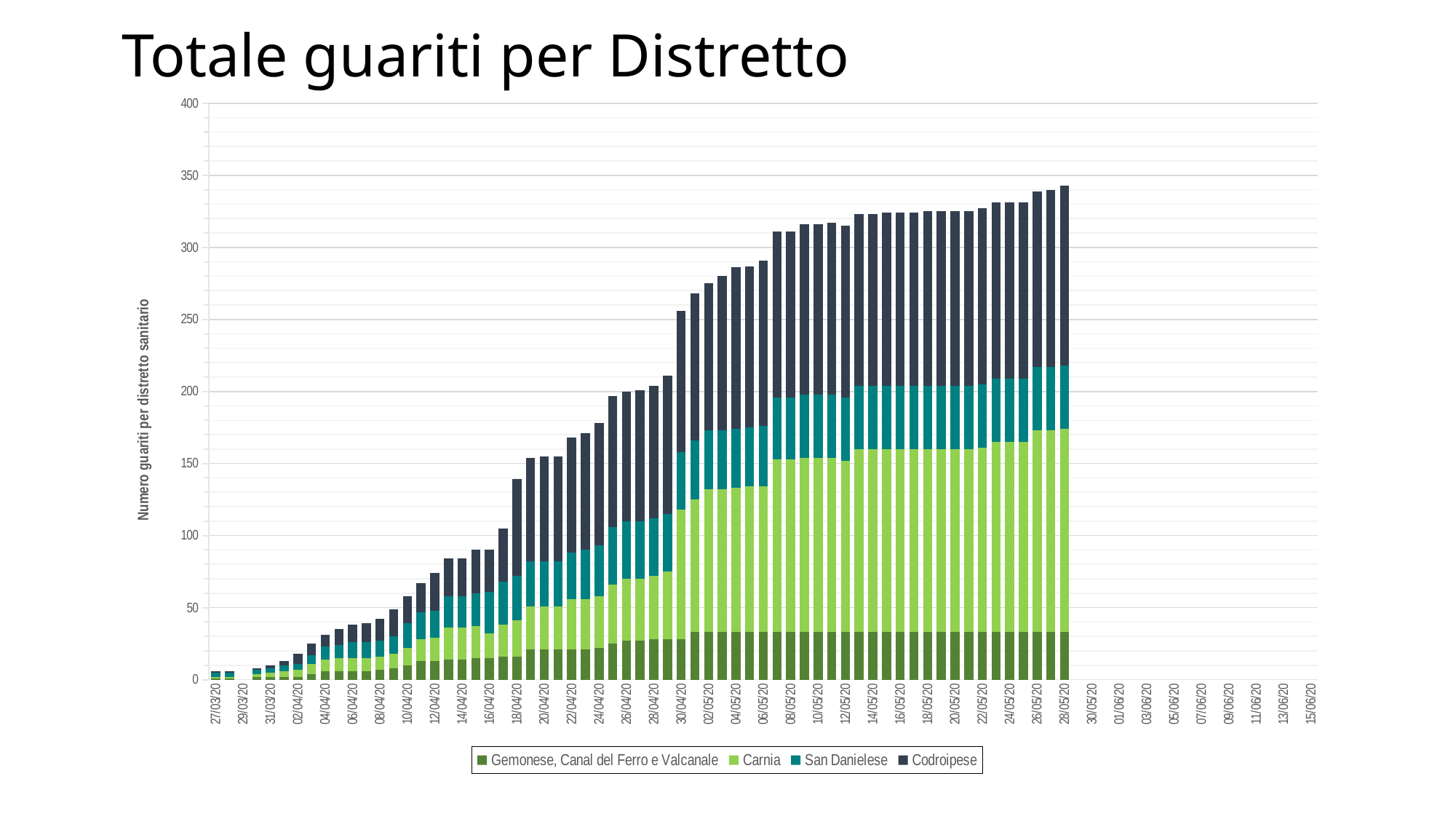
Is the total value for 20/04/20 greater or less than 100? greater Which has the larger total bar, 28/05/20 or 27/03/20? 28/05/20 Which series is plotted at the bottom of each stacked bar? Gemonese, Canal del Ferro e Valcanale Do the total values rise or fall along the x axis from 27/03/20 to 28/05/20? rise Is the total value for 08/05/20 greater or less than 300? greater Is the total value for 28/05/20 greater or less than 300? greater What kind of chart is shown on the slide? stacked bar chart Which date has the highest total bar? 28/05/20 How many series does the legend list? 4 What is the title of the chart? Totale guariti per Distretto